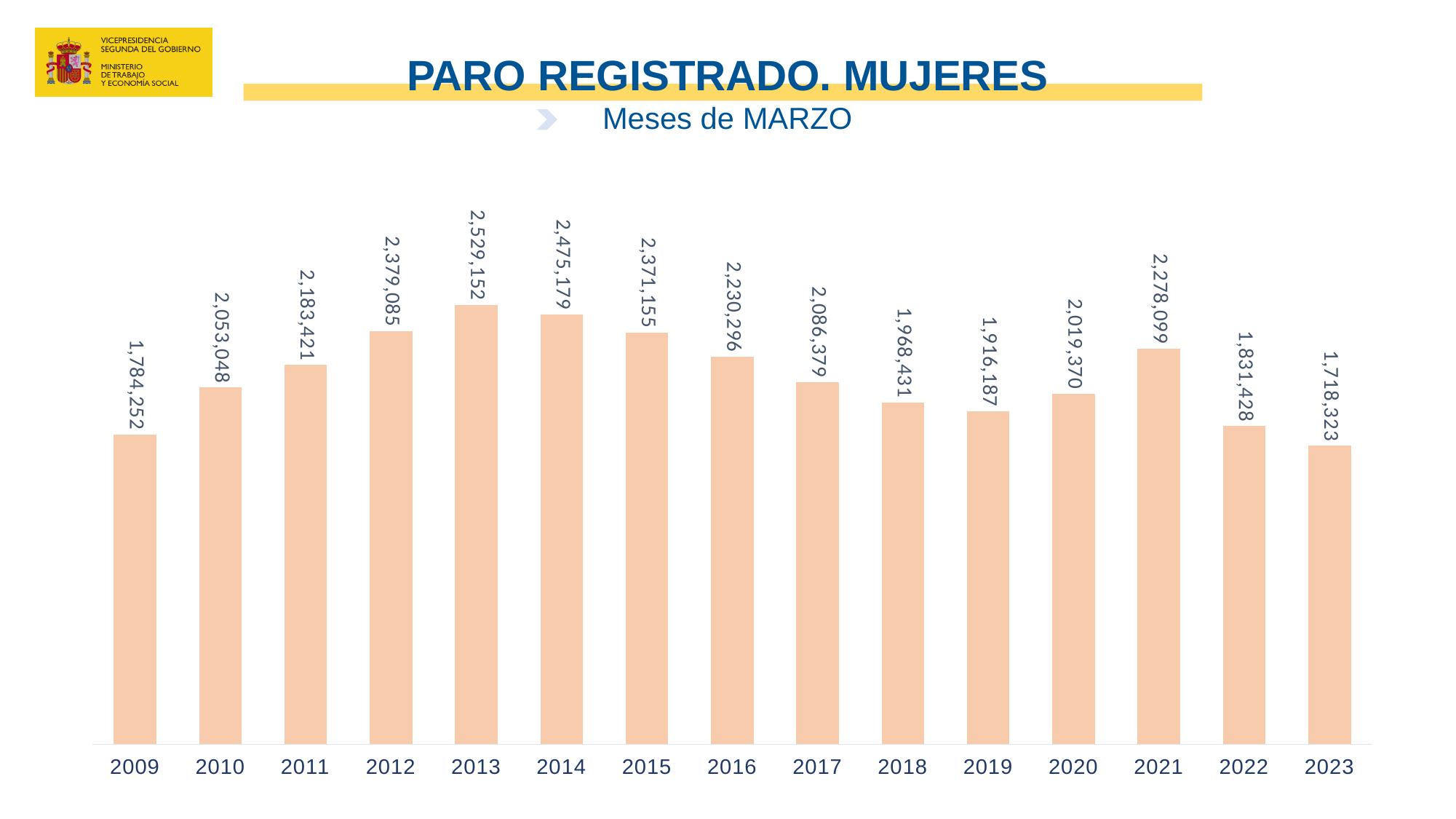
What is the value for 2013? 2,529,152 What is the difference between the values for 2013 and 2023? 810,829 Do the values rise or fall from 2021 to 2023? Fall What kind of chart is shown on the slide? Bar chart What is the value for 2023? 1,718,323 Which year has the lowest value? 2023 What is the difference between the values for 2022 and 2023? 113,105 How many years are shown on the x axis? 15 What is the value for 2009? 1,784,252 What is the value for 2021? 2,278,099 Which year has the highest value? 2013 Which is larger, the value for 2014 or the value for 2015? 2014